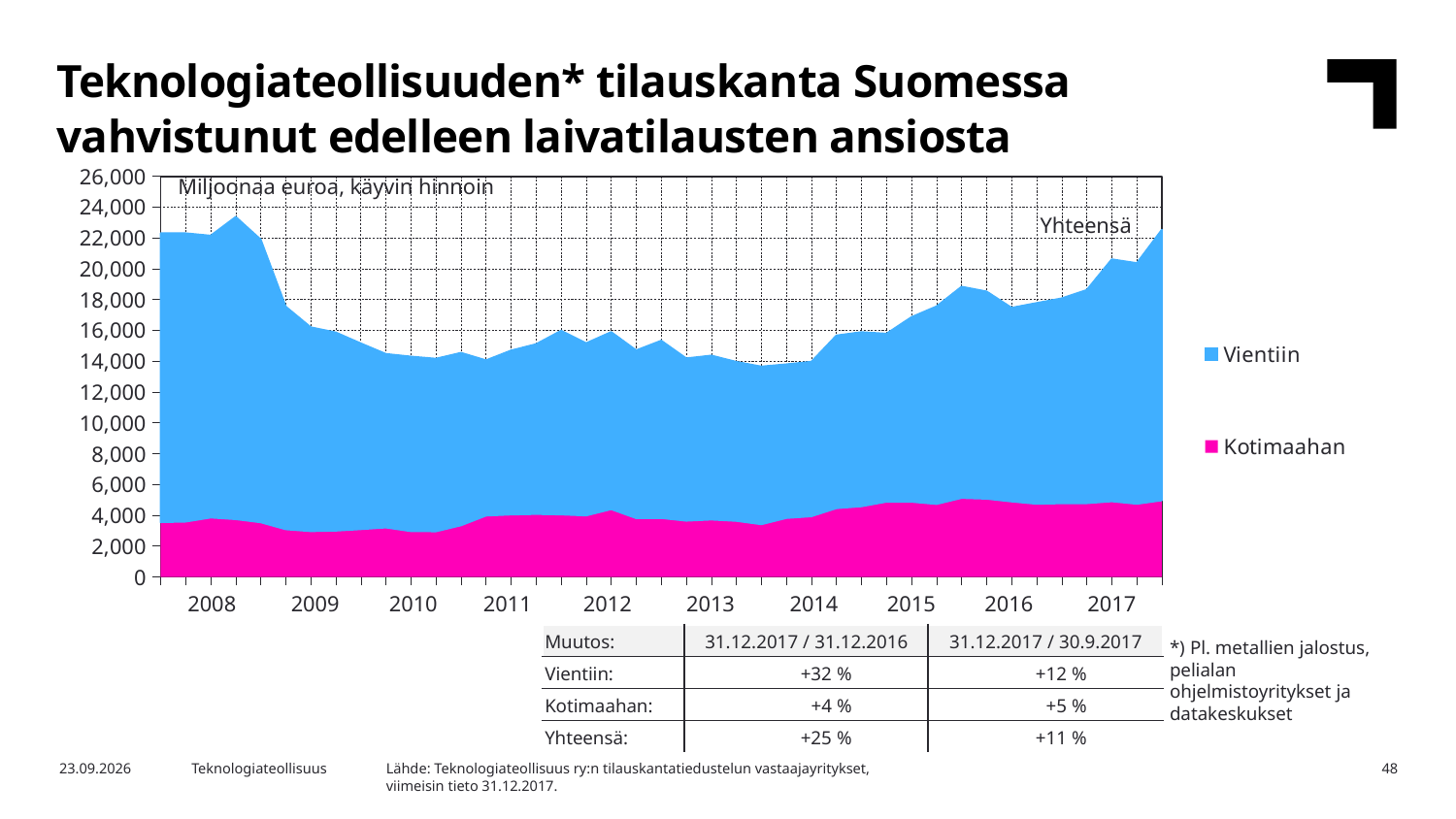
Is the total (Yhteensä) value during 2014 greater or less than 16,000? less What are the two series named in the chart legend? Vientiin and Kotimaahan Does the total (Yhteensä) value rise or fall from 2014 to the end of 2017? rise How many years are labelled on the x axis of the chart? 10 What unit label is printed inside the chart area? Miljoonaa euroa, käyvin hinnoin Is the Kotimaahan value at the end of 2017 greater or less than 4,000? greater Which series is larger throughout the chart, Vientiin or Kotimaahan? Vientiin How many series does the chart legend list? 2 Does the total (Yhteensä) value rise or fall from 2008 to 2009? fall Is the total (Yhteensä) value at the end of 2017 greater or less than 20,000? greater What type of chart is shown on the slide? Stacked area chart